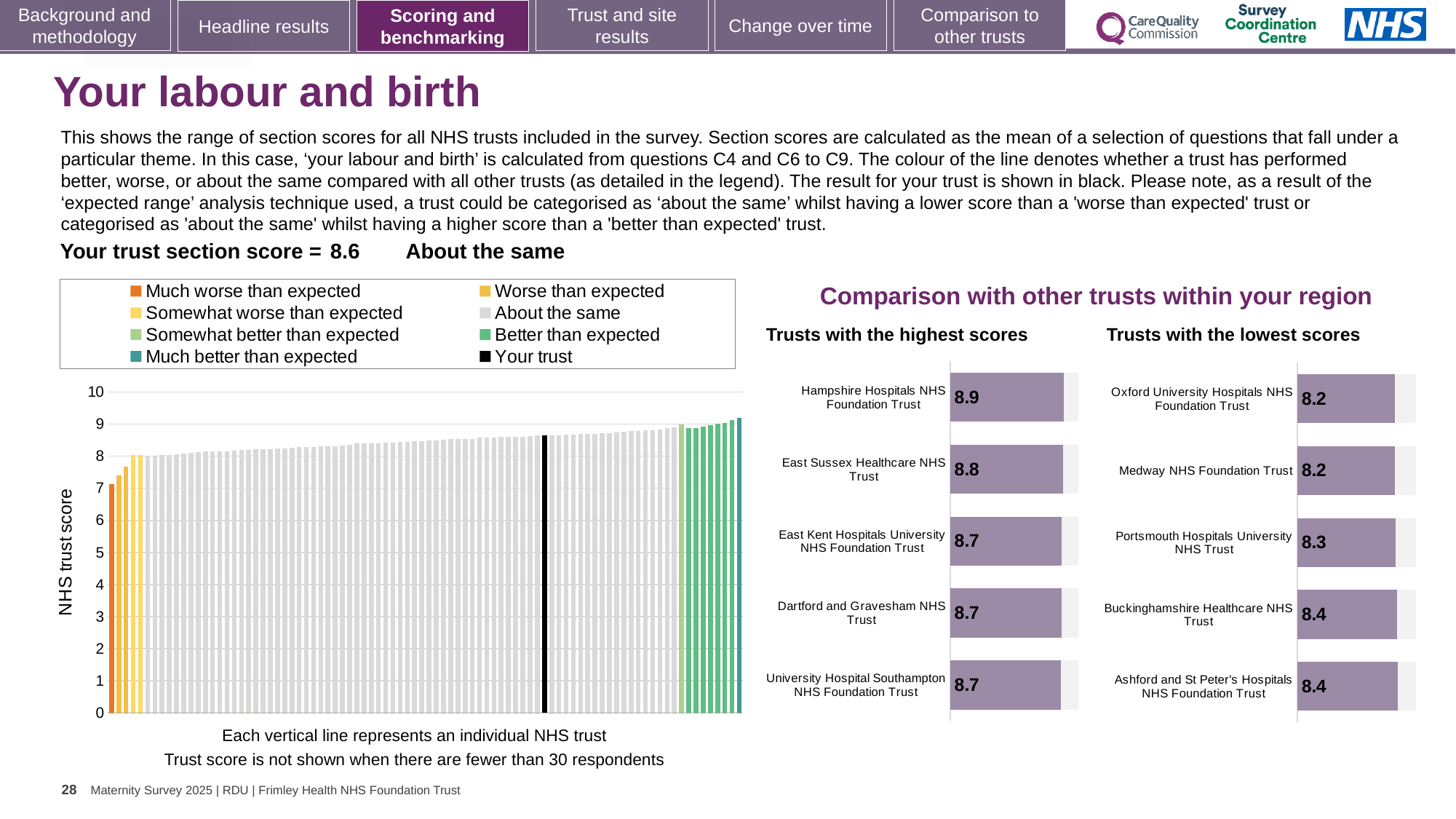
In the main chart on the left, do the trust scores rise or fall from left to right? Rise In the main chart on the left showing all NHS trusts, how many entries does the legend list? 8 In the 'Trusts with the lowest scores' chart, which trust has the highest score shown, Buckinghamshire Healthcare NHS Trust or Medway NHS Foundation Trust? Buckinghamshire Healthcare NHS Trust In the 'Trusts with the highest scores' chart, which trust has the highest score? Hampshire Hospitals NHS Foundation Trust In the 'Trusts with the lowest scores' chart, how many trusts are listed? 5 In the 'Trusts with the highest scores' chart, what is the score for Hampshire Hospitals NHS Foundation Trust? 8.9 What kind of chart is the main chart on the left showing NHS trust scores? Bar chart What is the difference between the score for Hampshire Hospitals NHS Foundation Trust in the highest-scores chart and the score for Oxford University Hospitals NHS Foundation Trust in the lowest-scores chart? 0.7 In the 'Trusts with the highest scores' chart, how many trusts are listed? 5 In the main chart on the left, is the value of the leftmost (orange) bar greater or less than 8? less In the main chart on the left, what colour is used to show 'Your trust'? Black In the 'Trusts with the lowest scores' chart, what is the score for Portsmouth Hospitals University NHS Trust? 8.3